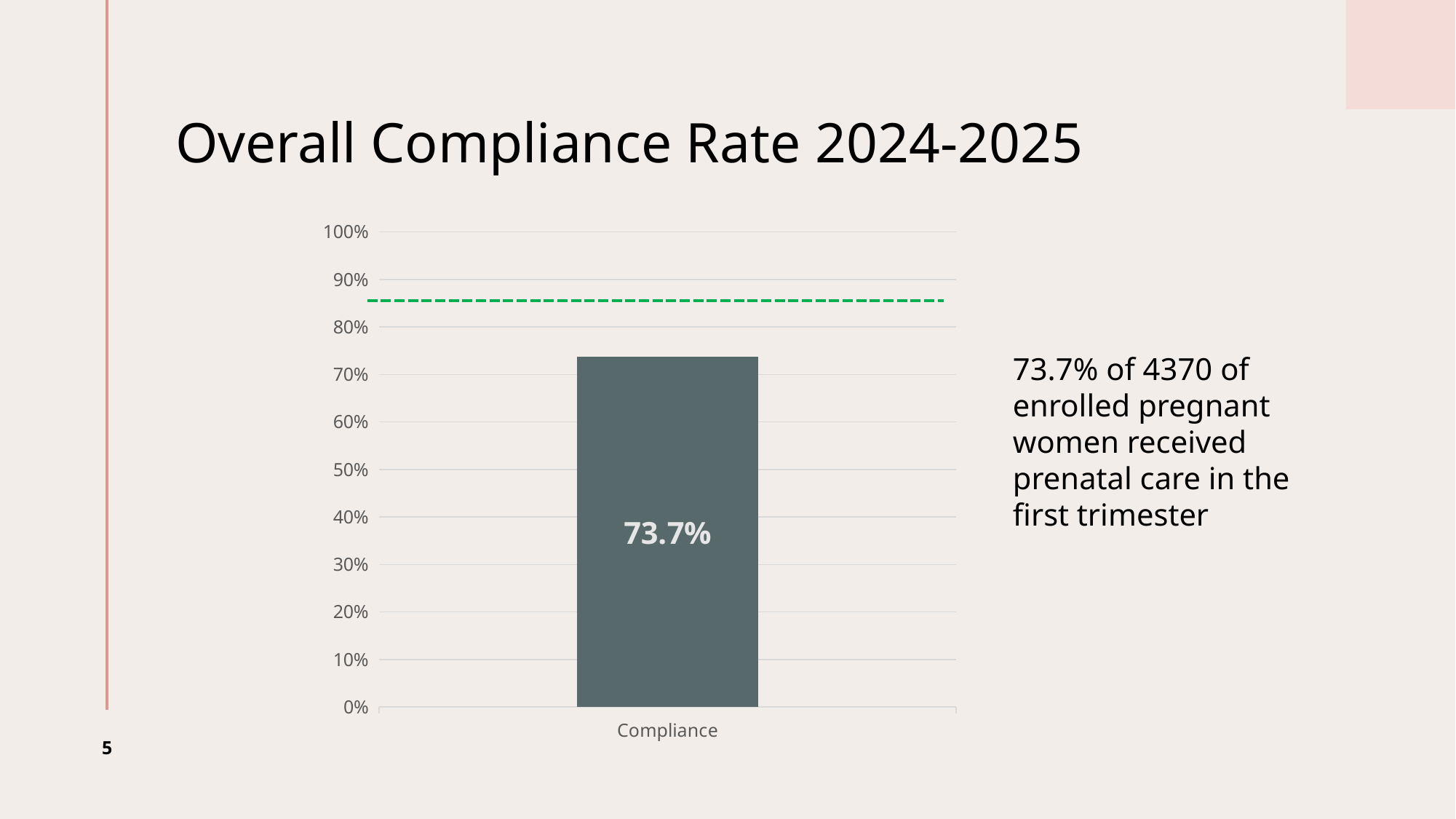
What kind of chart is shown on the slide? bar chart What is the label of the single category on the x axis? Compliance Is the value for Compliance greater or less than 80%? less What is the value of the Compliance bar? 73.7% What is the maximum value shown on the y axis? 100% Is the Compliance bar above or below the green dashed line? below Is the green dashed line greater or less than 80%? greater How many bars are plotted in the chart? 1 Is the value for Compliance greater or less than 70%? greater